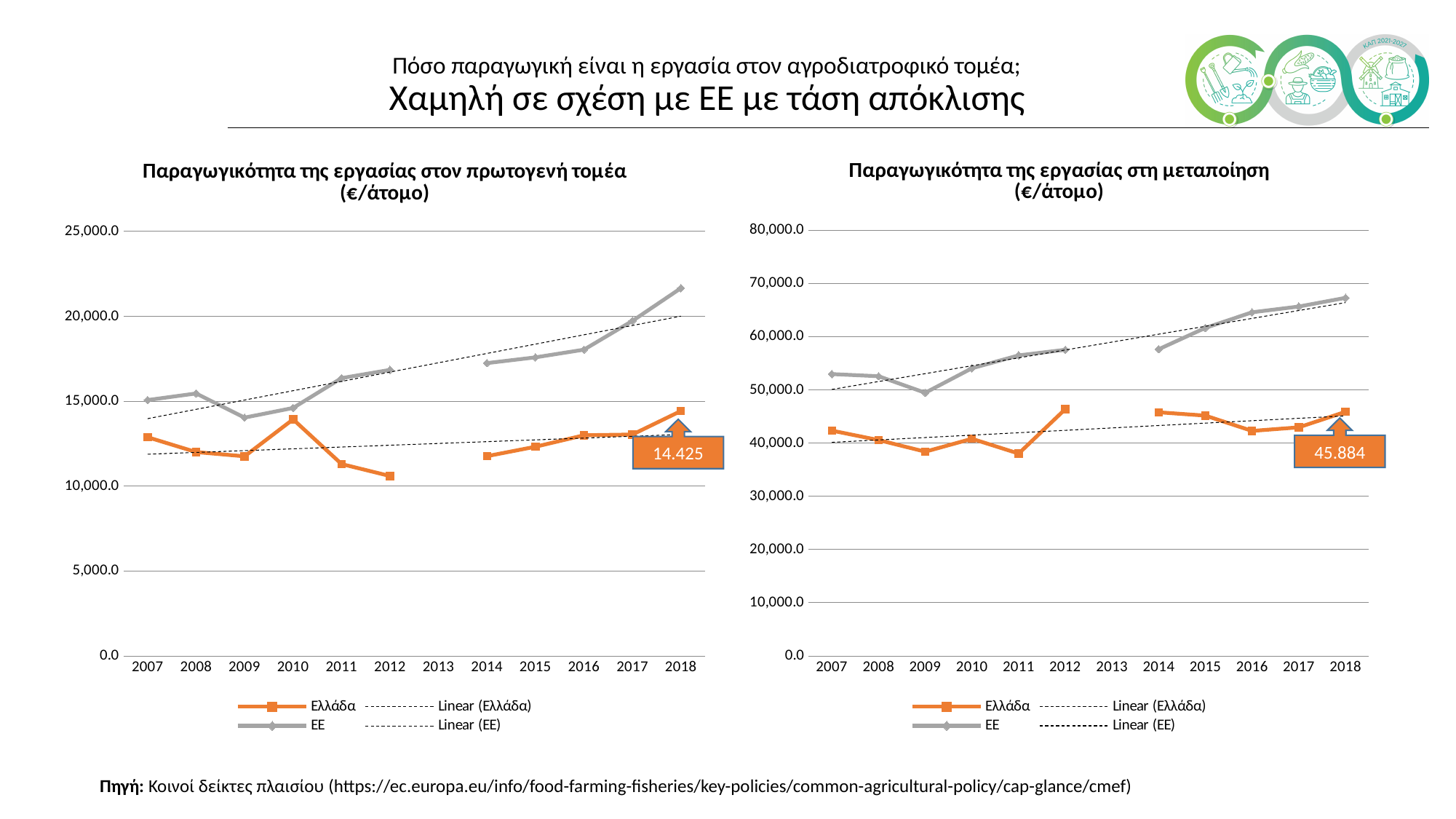
In the left chart (πρωτογενή τομέα), what is the labelled value for Ελλάδα in 2018? 14.425 In the left chart (πρωτογενή τομέα), which series has the larger value in 2018, Ελλάδα or ΕΕ? ΕΕ In the right chart (μεταποίηση), does the ΕΕ series rise or fall from 2014 to 2018? rise In the right chart (μεταποίηση), what is the labelled value for Ελλάδα in 2018? 45.884 How many years are shown on the x axis of the left chart (πρωτογενή τομέα)? 12 How many entries does the legend of the right chart (μεταποίηση) list? 4 What kind of chart is the left chart, 'Παραγωγικότητα της εργασίας στον πρωτογενή τομέα'? line chart In the right chart (μεταποίηση), is the value for Ελλάδα in 2012 greater or less than 40,000.0? greater In the right chart (μεταποίηση), in which year is the ΕΕ value lowest? 2009 In the right chart (μεταποίηση), is the value for ΕΕ in 2018 greater or less than 60,000.0? greater In the left chart (πρωτογενή τομέα), is the value for Ελλάδα in 2012 greater or less than 15,000.0? less